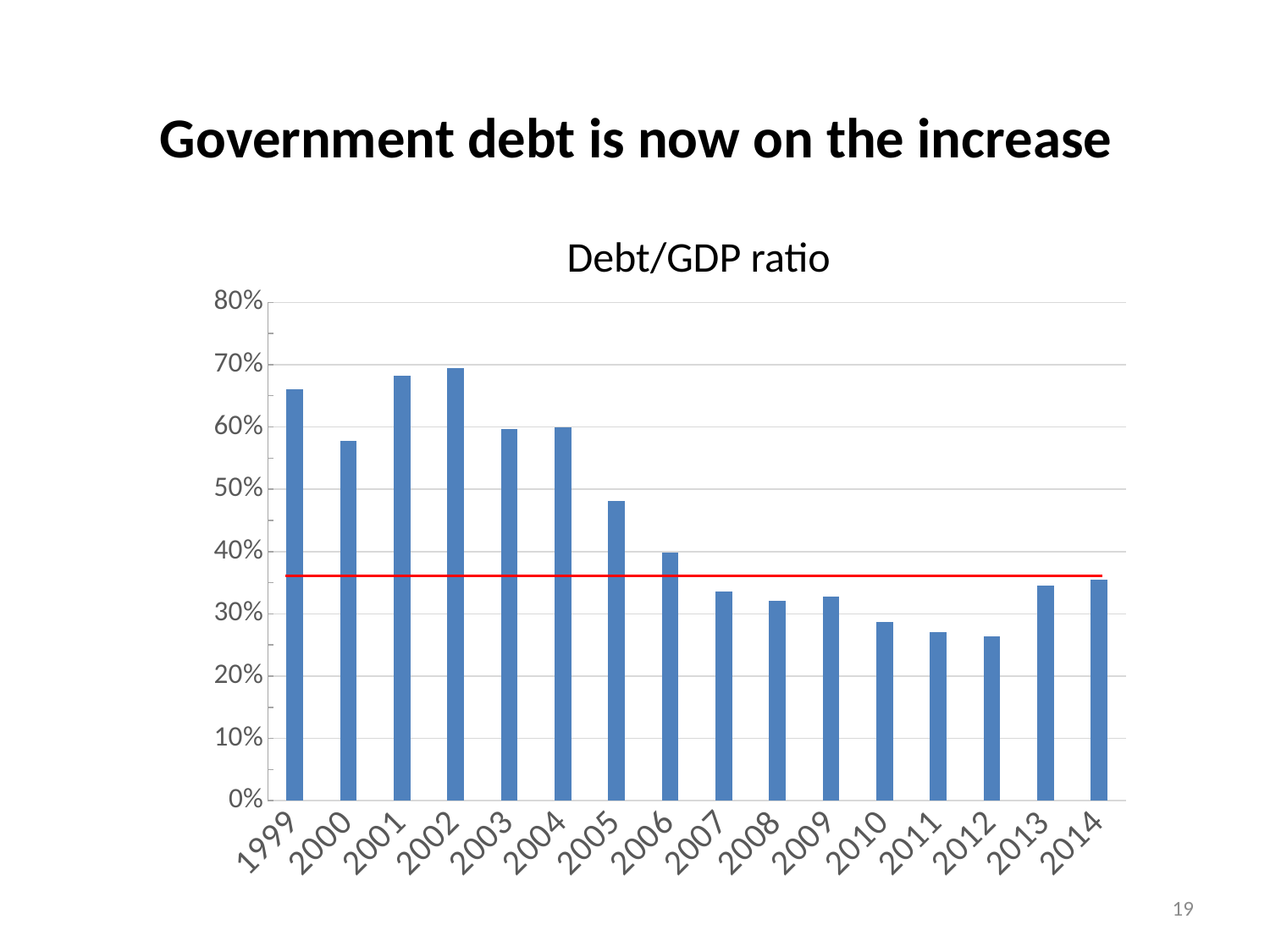
How many years are plotted on the x axis of the chart? 16 Is the Debt/GDP ratio for 2012 greater or less than 30%? less Is the Debt/GDP ratio for 2000 greater or less than 50%? greater Is the Debt/GDP ratio for 2014 greater or less than 40%? less What is the title of the chart? Debt/GDP ratio Does the Debt/GDP ratio generally rise or fall from 2002 to 2012? fall What kind of chart is shown on the slide? bar chart Does the Debt/GDP ratio rise or fall from 2012 to 2014? rise Which year has the higher Debt/GDP ratio, 2002 or 2010? 2002 Which year has the higher Debt/GDP ratio, 2006 or 2007? 2006